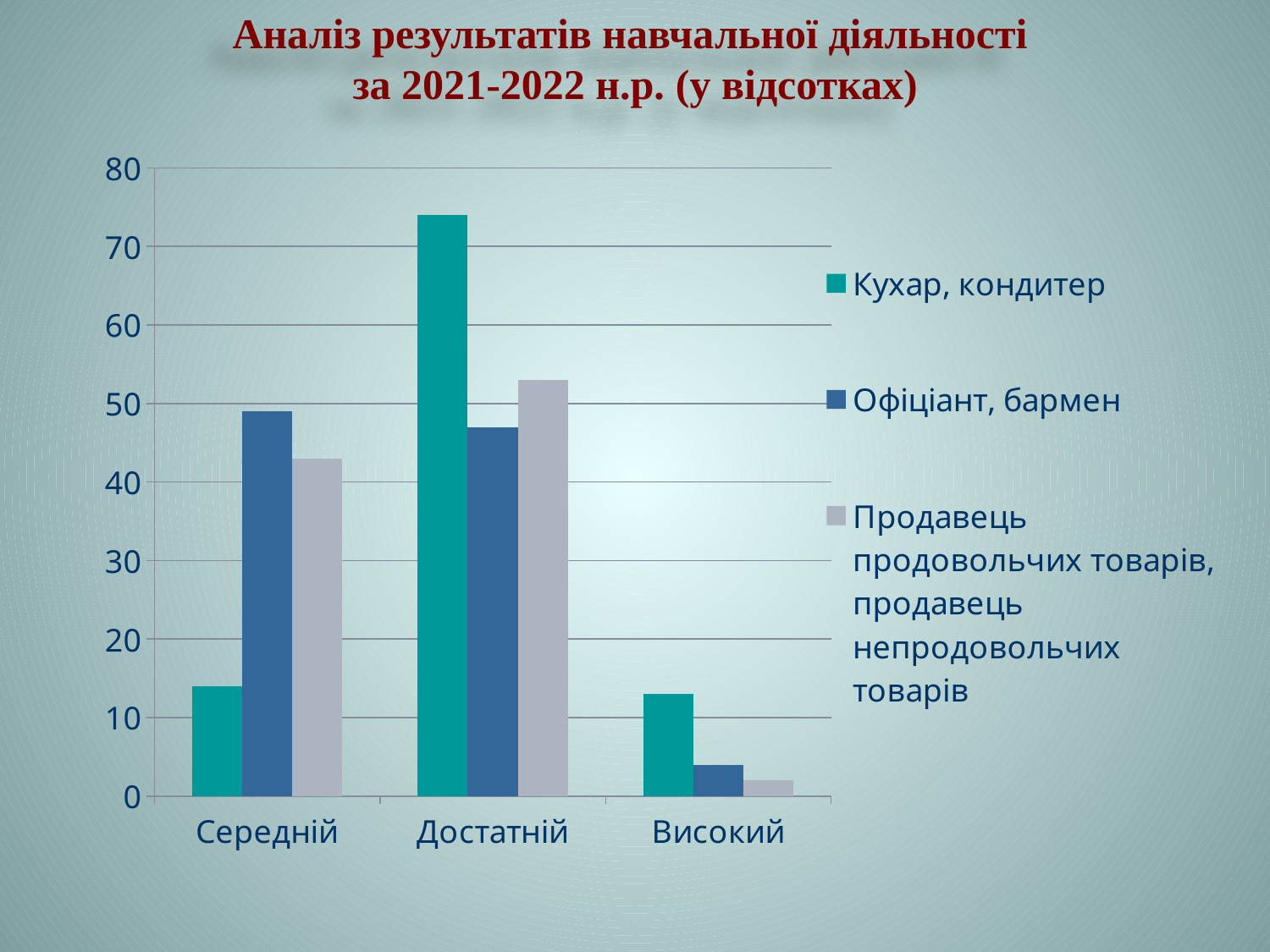
Which category has the lowest value for the series "Офіціант, бармен"? Високий Is the value for "Кухар, кондитер" in the "Достатній" category greater or less than 70? greater What kind of chart is shown on the slide? bar chart Which series has the lowest value in the "Високий" category? Продавець продовольчих товарів, продавець непродовольчих товарів How many series does the legend list? 3 How many categories are shown on the x axis? 3 What is the title of the chart on the slide? Аналіз результатів навчальної діяльності за 2021-2022 н.р. (у відсотках) Which category has the highest value for the series "Кухар, кондитер"? Достатній Is the value for "Офіціант, бармен" in the "Високий" category greater or less than 10? less Is the value for "Кухар, кондитер" in the "Середній" category greater or less than 20? less In the "Достатній" category, which is larger: the value for "Кухар, кондитер" or the value for "Офіціант, бармен"? Кухар, кондитер Which series has the highest value in the "Середній" category? Офіціант, бармен